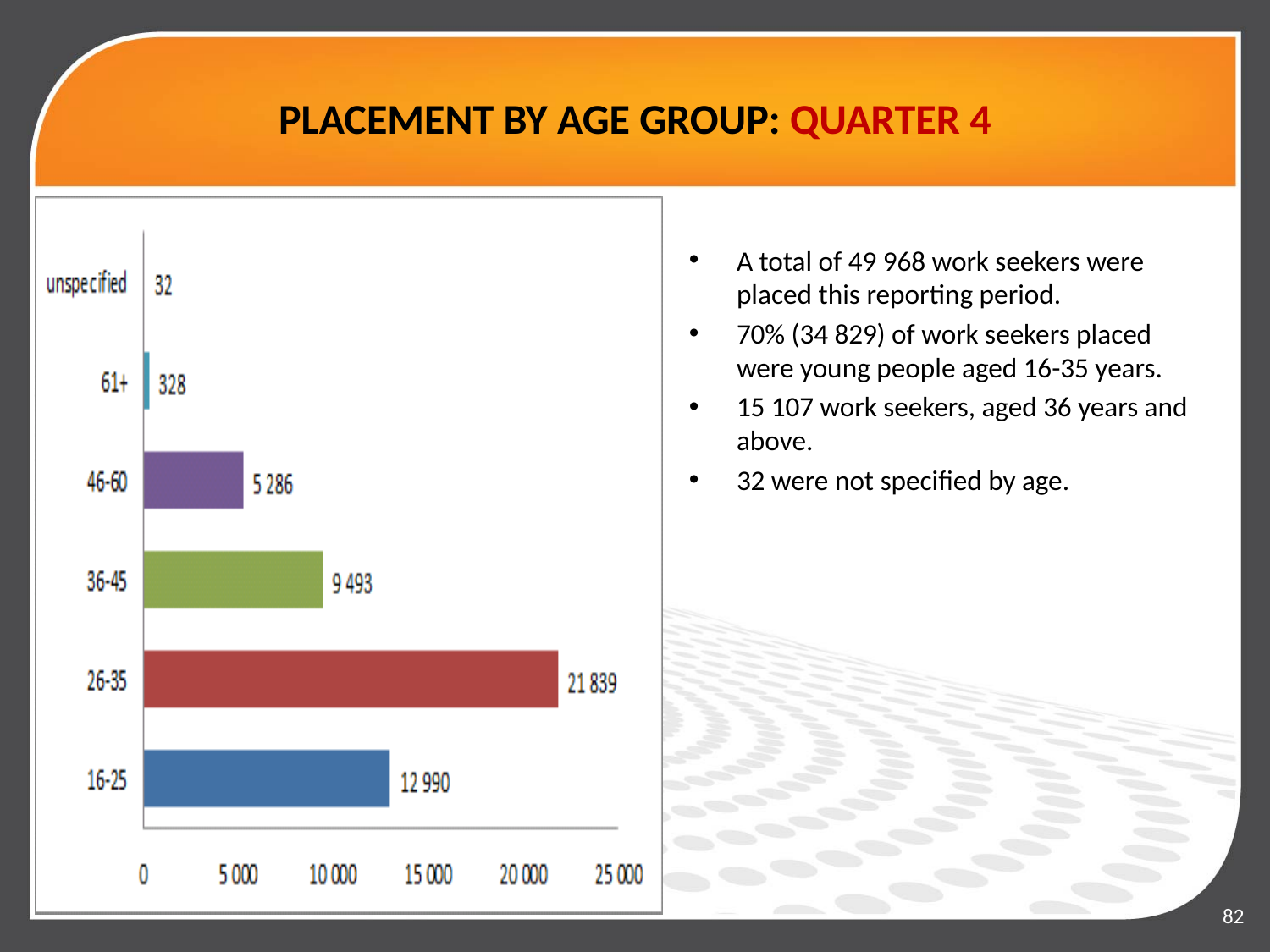
Which is larger, the value for 36-45 or the value for 46-60? 36-45 What is the value for the 46-60 age group? 5 286 Which age group has the highest placement value? 26-35 What kind of chart is shown on the slide? bar chart How many categories are shown in the chart? 6 What is the value for the 61+ age group? 328 Is the value for 36-45 greater or less than 10 000? less What is the value for the 16-25 age group? 12 990 What is the maximum value shown on the horizontal axis? 25 000 What is the difference between the values for 26-35 and 16-25? 8 849 Which category has the lowest value? unspecified What is the value for the 26-35 age group? 21 839